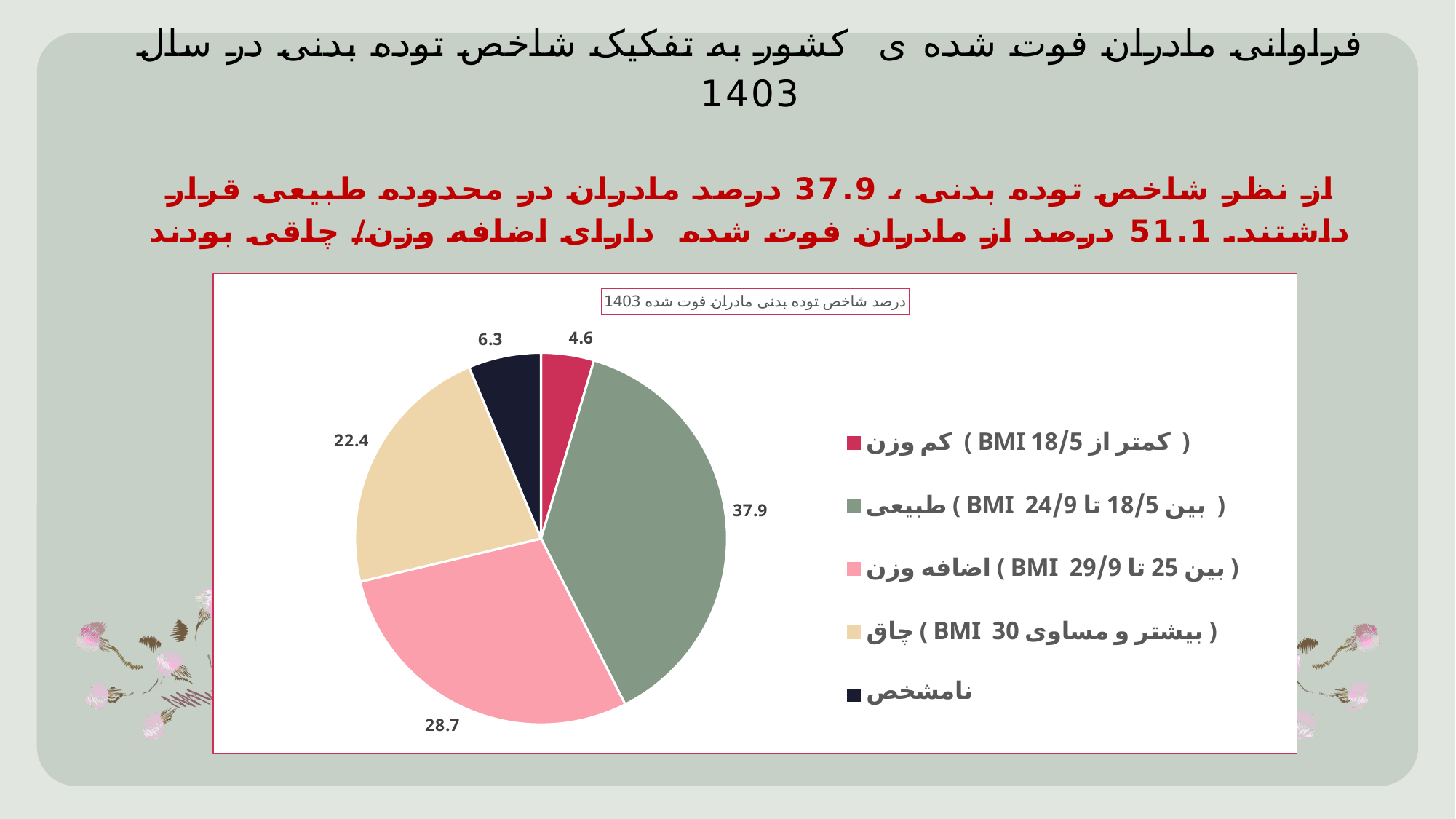
What is the value for the 'نامشخص' slice? 6.3 What is the value for the 'طبیعی' (BMI 18/5 to 24/9) slice? 37.9 What kind of chart is shown on the slide? pie chart What is the difference between the 'طبیعی' slice and the 'اضافه وزن' slice? 9.2 What is the value for the 'کم وزن' (BMI less than 18/5) slice? 4.6 How many slices does the pie chart have? 5 What is the value for the 'اضافه وزن' (BMI 25 to 29/9) slice? 28.7 Which category has the smallest slice of the pie? کم وزن (BMI less than 18/5) What is the value for the 'چاق' (BMI 30 or more) slice? 22.4 Which category has the largest slice of the pie? طبیعی (BMI 18/5 to 24/9) Which is larger, the 'چاق' slice or the 'نامشخص' slice? چاق What colour is the 'اضافه وزن' (BMI 25 to 29/9) slice? pink